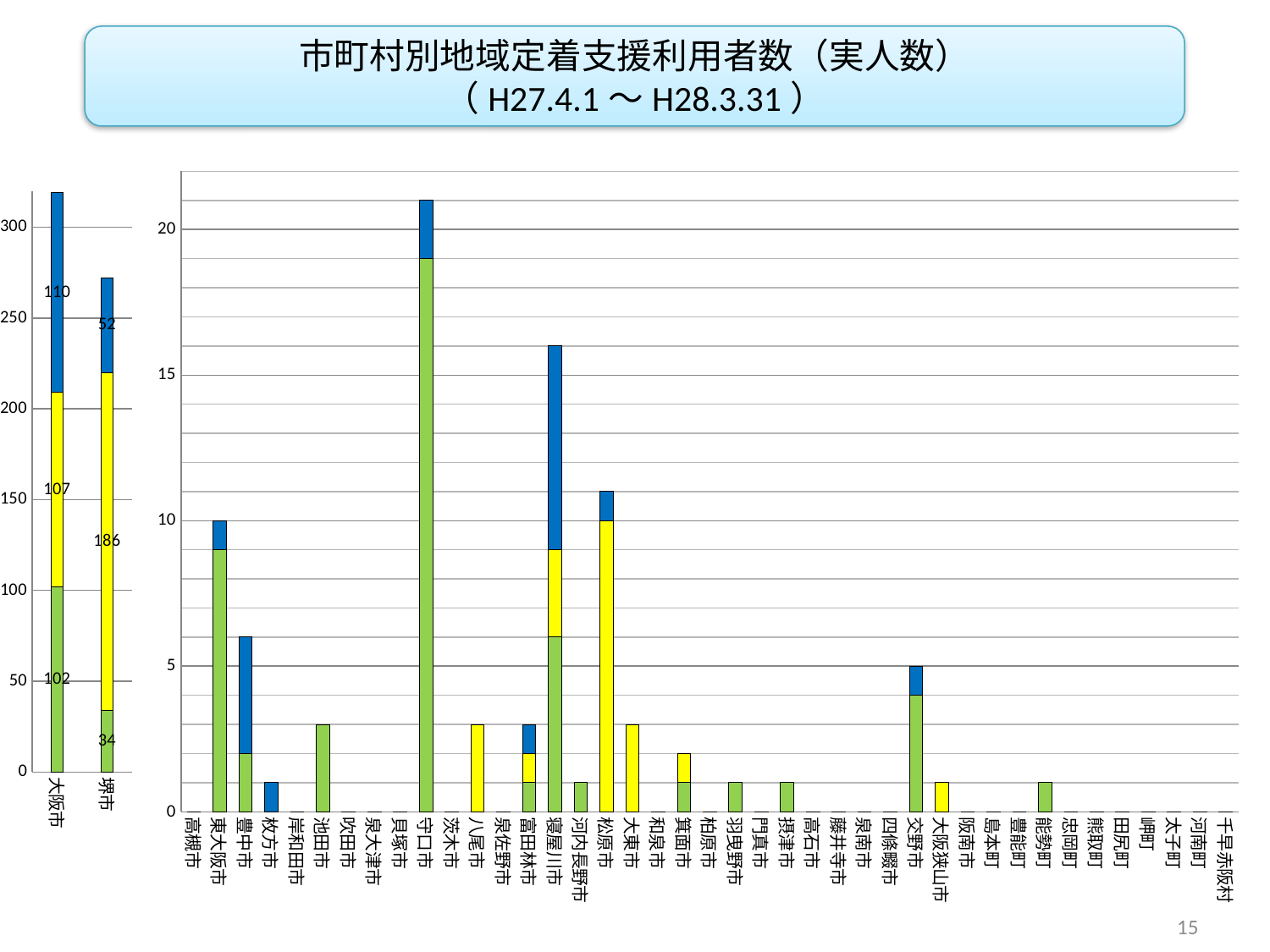
On the left chart, which has the larger green segment, 大阪市 or 堺市? 大阪市 On the right chart, which municipality has the highest bar? 守口市 On the left chart, what is the difference between the yellow segment of 堺市 and the yellow segment of 大阪市? 79 On the left chart, what is the value of the green segment for 大阪市? 102 What kind of chart is the right chart? bar chart On the right chart, is the value for 寝屋川市 greater or less than 15? greater On the left chart, what is the value of the yellow segment for 堺市? 186 On the left chart, what is the total of the stacked bar for 堺市? 272 On the left chart, what is the value of the blue segment for 大阪市? 110 On the left chart, what is the total of the stacked bar for 大阪市? 319 On the right chart, is the value for 池田市 greater or less than 5? less On the right chart, is the value for 守口市 greater or less than 20? greater